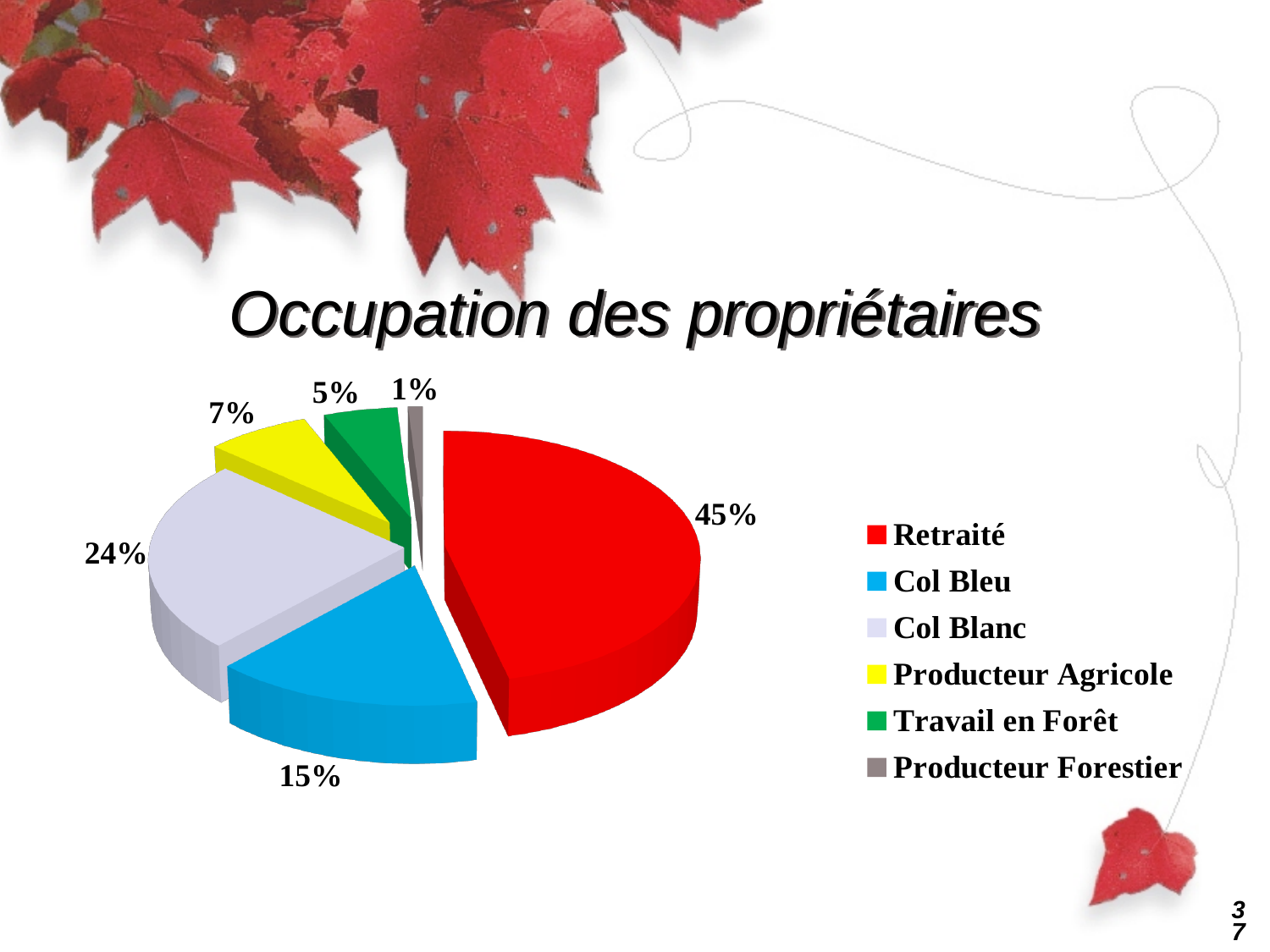
What percentage is shown for Col Blanc? 24% What is the difference in percentage points between Retraité and Col Blanc? 21 What percentage is shown for Col Bleu? 15% What share of the pie does Retraité represent? 45% What type of chart is shown on the slide? Pie chart Which category has the smallest slice of the pie? Producteur Forestier What percentage is shown for Producteur Agricole? 7% How many categories does the pie chart show? 6 What percentage is shown for Producteur Forestier? 1% Which is larger, Col Bleu or Col Blanc? Col Blanc Which category has the largest slice of the pie? Retraité What is the title of the chart? Occupation des propriétaires